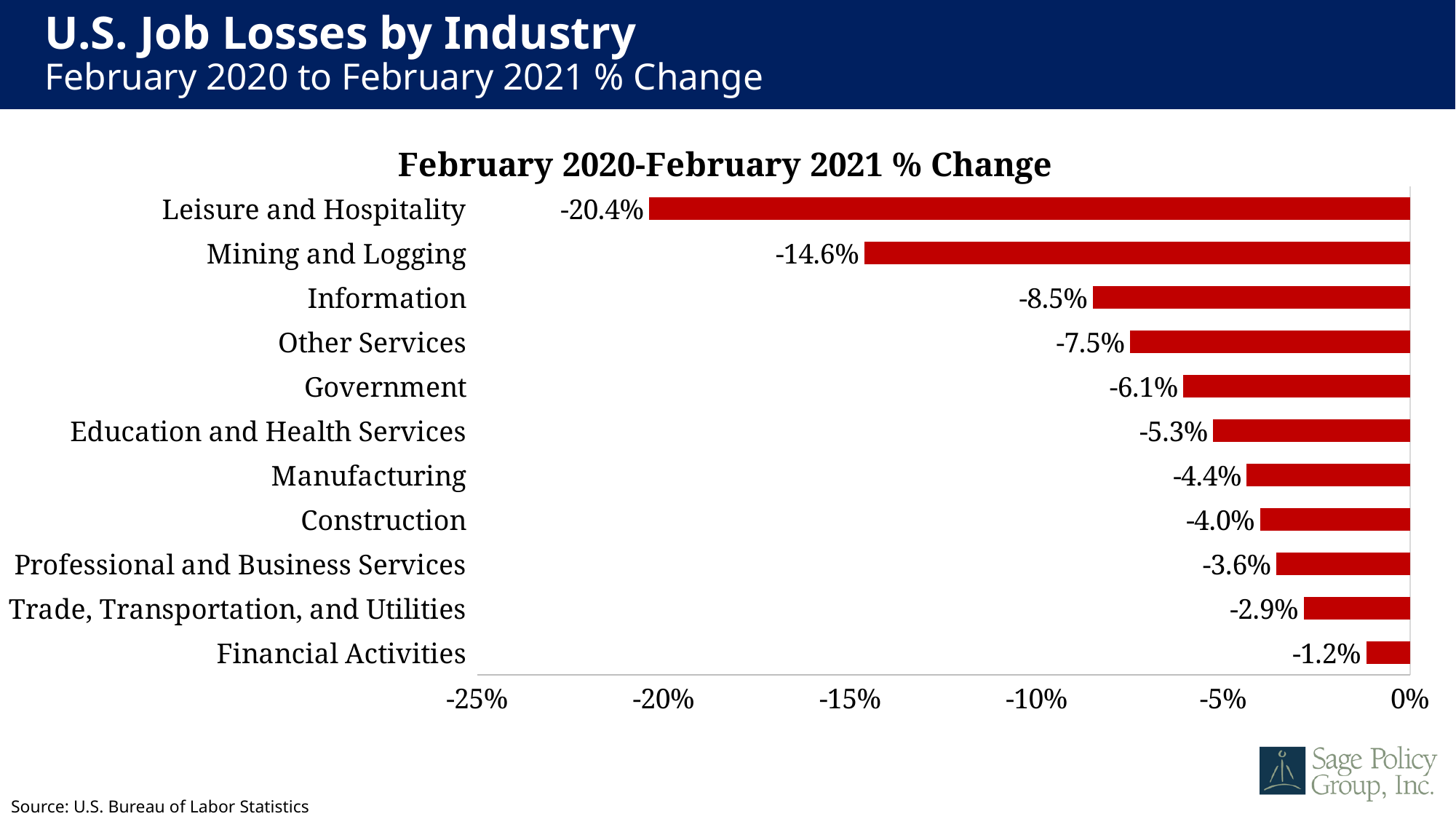
Which industry has the smallest job loss (least negative % change)? Financial Activities What is the source cited for the chart data? U.S. Bureau of Labor Statistics Is the % change for Manufacturing greater or less than -5%? greater Which industry has the largest job loss (most negative % change)? Leisure and Hospitality What is the February 2020 to February 2021 % change for Mining and Logging? -14.6% What is the % change shown for Government? -6.1% What is the % change shown for Trade, Transportation, and Utilities? -2.9% What is the title of the chart? February 2020-February 2021 % Change How many industries are shown in the chart? 11 What is the difference in percentage points between the % change for Leisure and Hospitality and Mining and Logging? 5.8 percentage points Which industry had a larger job loss, Information or Other Services? Information What type of chart is used on the slide? Bar chart